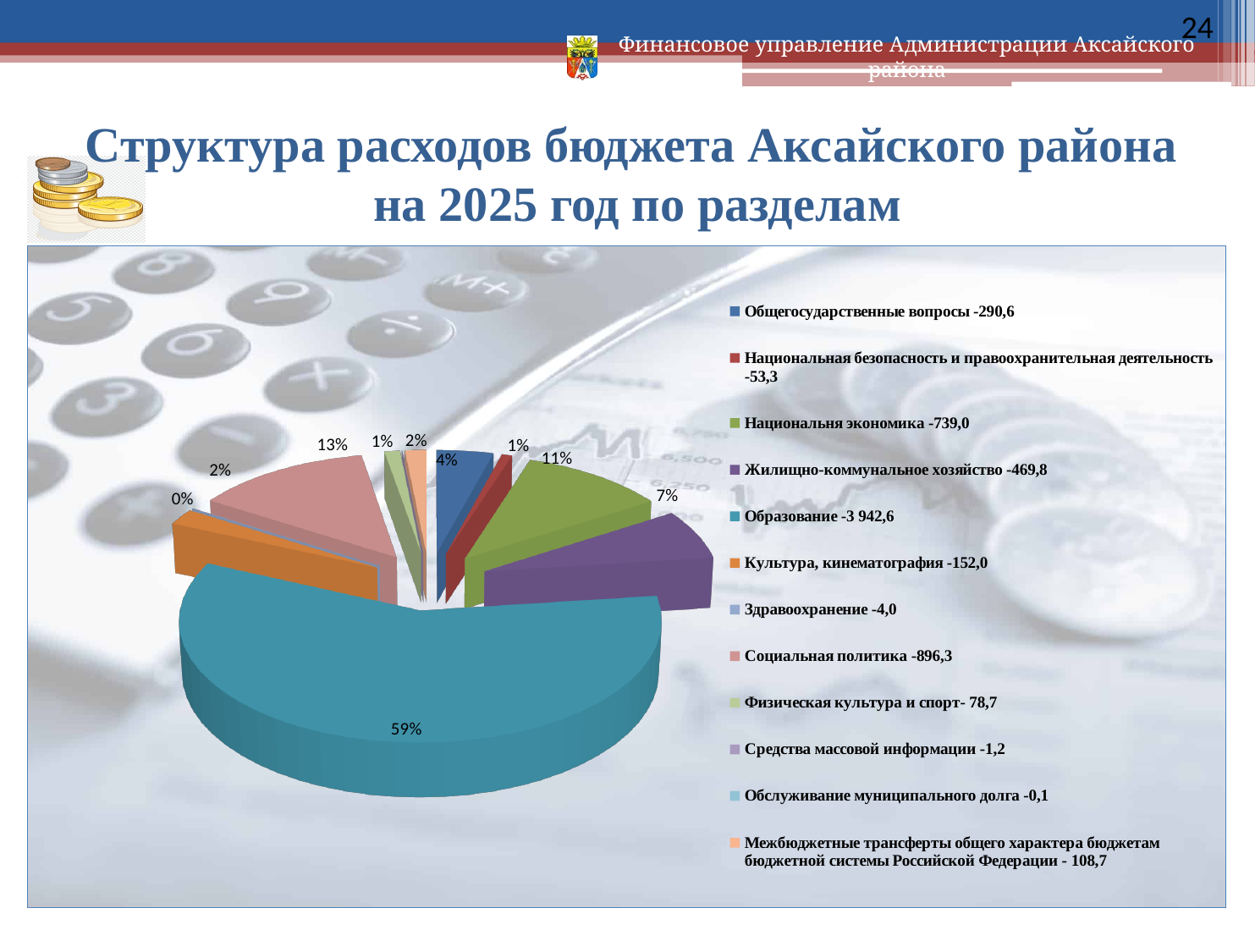
What share of the pie does Образование take? 59% What value is given in the legend for Обслуживание муниципального долга? 0,1 What share of the pie does Социальная политика take? 13% What kind of chart is shown on the slide? pie chart How many categories does the legend list? 12 What value is given in the legend for Образование? 3 942,6 Which category has the largest slice of the pie? Образование What share of the pie does Жилищно-коммунальное хозяйство take? 7% Which is larger: Национальня экономика or Жилищно-коммунальное хозяйство? Национальня экономика Which category has the smallest value in the legend? Обслуживание муниципального долга What value is given in the legend for Социальная политика? 896,3